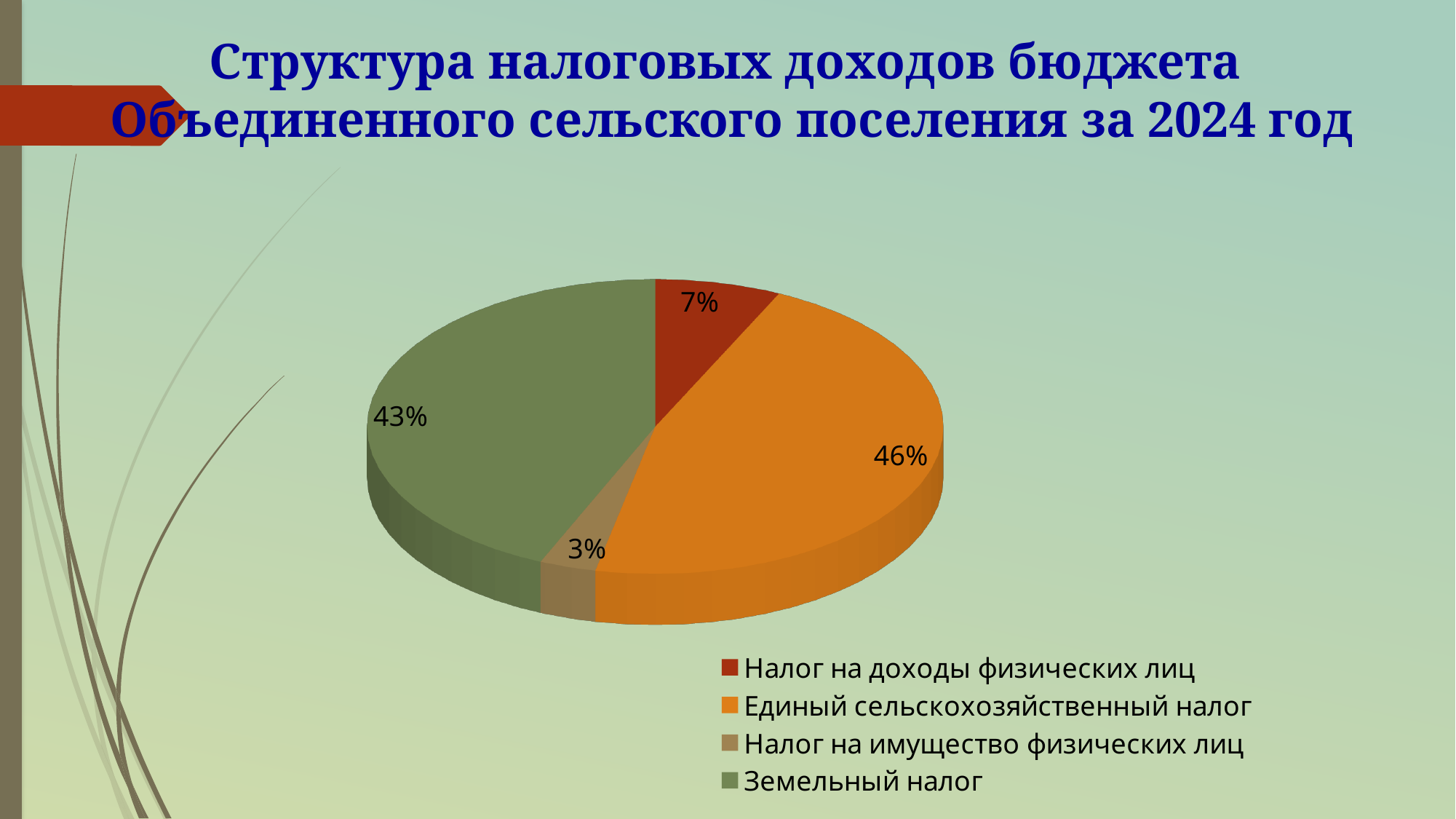
What share of the pie does Земельный налог have? 43% What kind of chart is shown on the slide? Pie chart What is the difference between the shares of Единый сельскохозяйственный налог and Земельный налог? 3% How many categories does the pie chart show? 4 What is the value shown for Налог на имущество физических лиц? 3% Which category has the smallest share of the pie? Налог на имущество физических лиц What share of the pie does Единый сельскохозяйственный налог have? 46% Which is larger: the share of Налог на доходы физических лиц or the share of Налог на имущество физических лиц? Налог на доходы физических лиц What is the title of the chart on the slide? Структура налоговых доходов бюджета Объединенного сельского поселения за 2024 год Which colour represents Земельный налог in the legend? Green What is the value shown for Налог на доходы физических лиц? 7% Which category has the largest share of the pie? Единый сельскохозяйственный налог